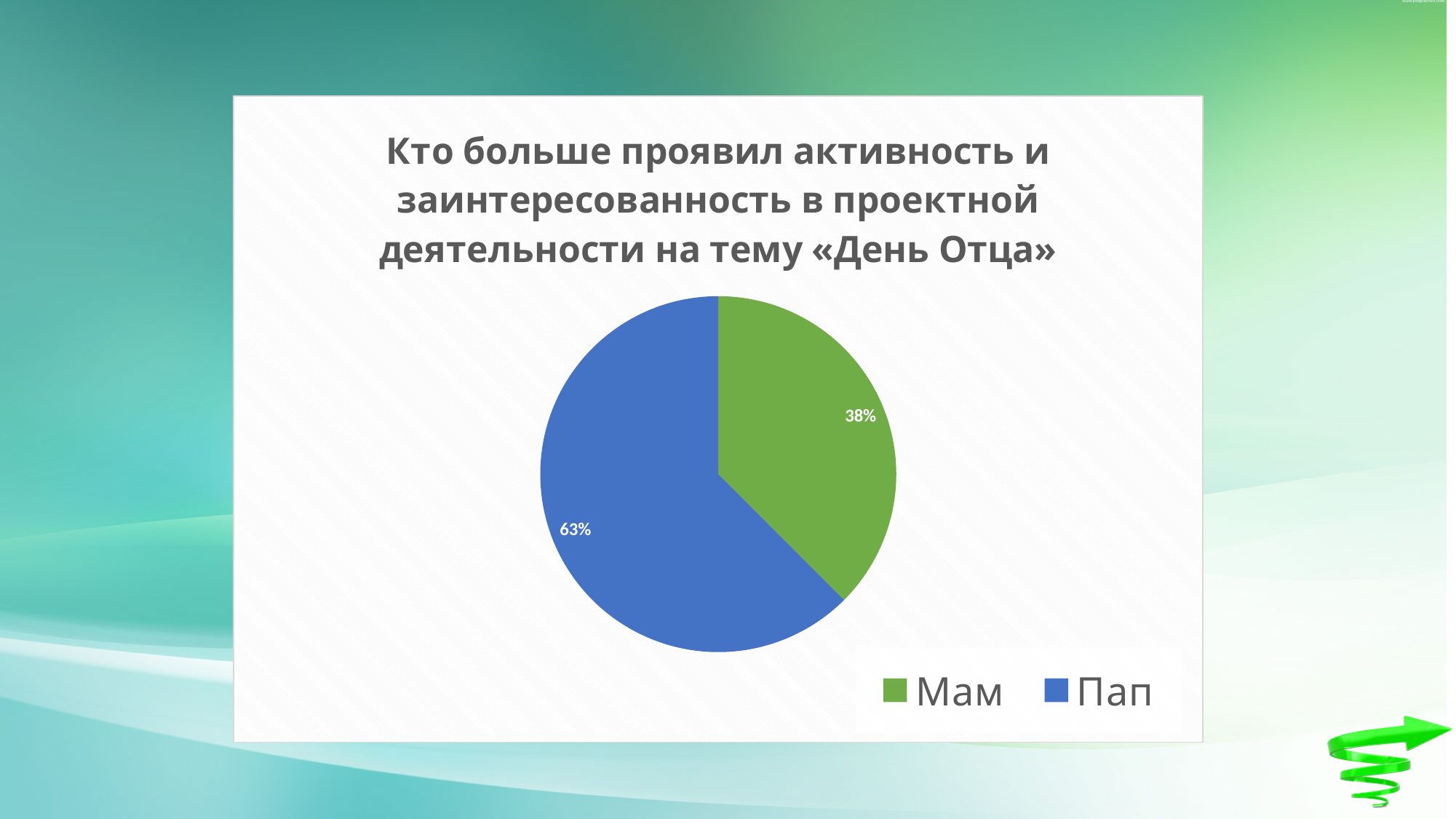
What is the difference in percentage points between the Пап slice and the Мам slice? 25 Which category has the largest slice of the pie? Пап What colour is the slice for Пап? blue How many slices does the pie chart have? 2 What share of the pie does Мам have? 38% Which category has the smallest slice of the pie? Мам What kind of chart is shown on the slide? pie chart What share of the pie does Пап have? 63% Which is larger, the slice for Мам or the slice for Пап? Пап What colour is the slice for Мам? green How many entries does the legend list? 2